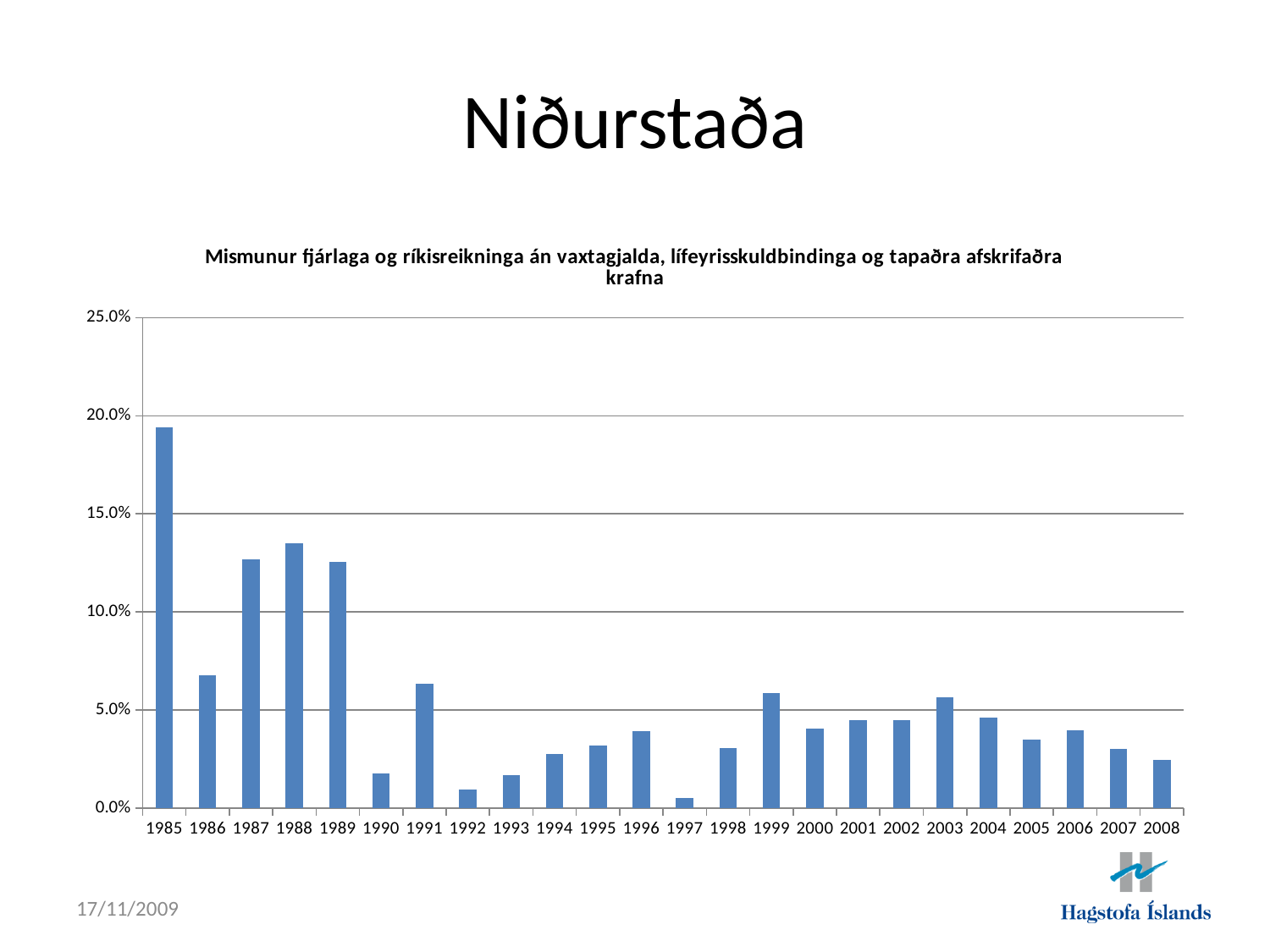
Which year has the highest value in the chart? 1985 Is the value for 1990 greater or less than 5.0%? less How many years are shown on the x axis of the chart? 24 Overall, do the values rise or fall from 1985 to 2008? fall Which year has the larger value, 1991 or 1992? 1991 Which year has the lowest value in the chart? 1997 What kind of chart is shown on the slide? bar chart Is the value for 1985 greater or less than 15.0%? greater Is the value for 1999 greater or less than 5.0%? greater Which year has the larger value, 1985 or 1986? 1985